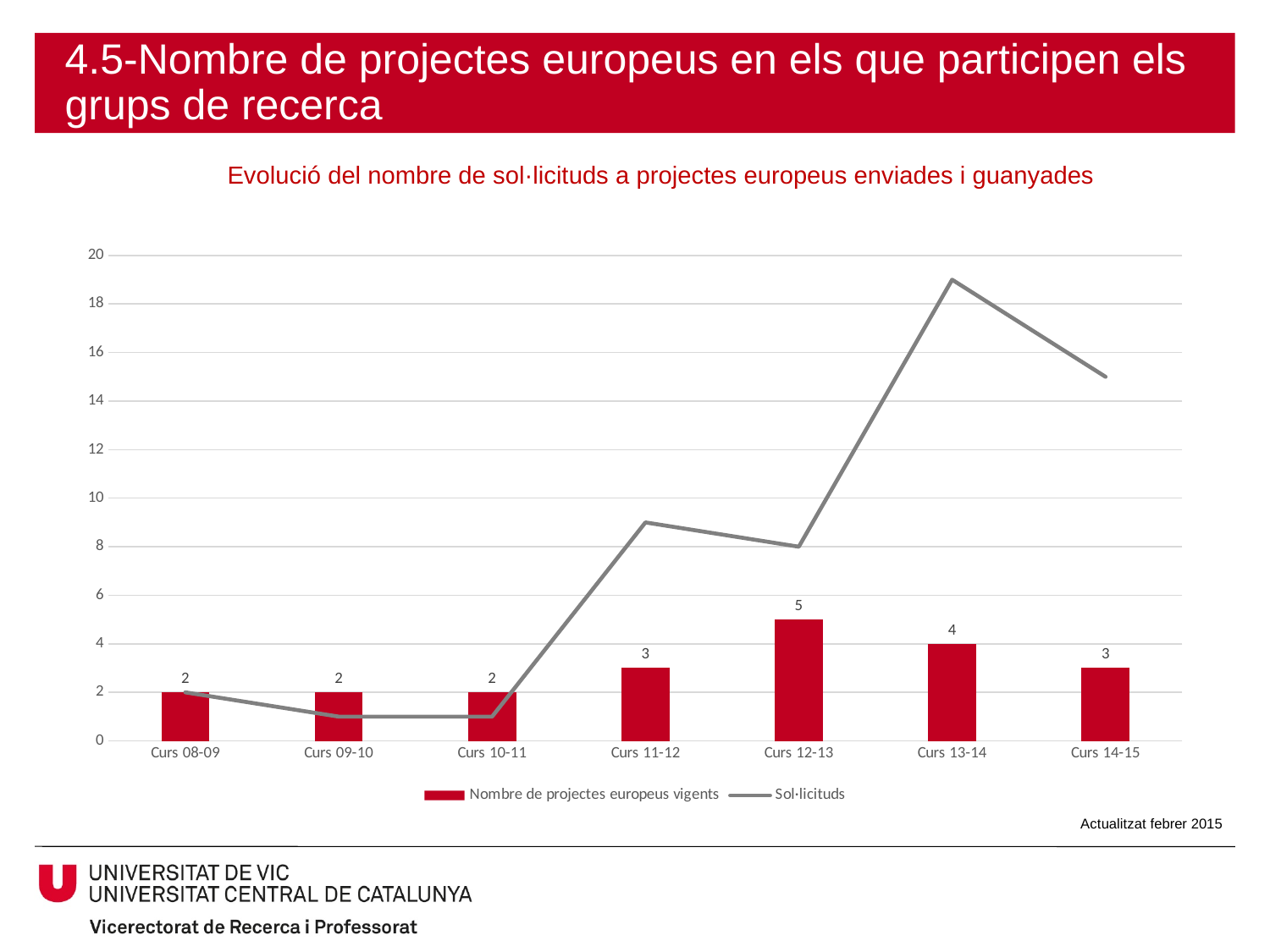
Does the Sol·licituds line rise or fall between Curs 13-14 and Curs 14-15? fall Which Curs has the highest value for Nombre de projectes europeus vigents? Curs 12-13 Is the Sol·licituds value for Curs 09-10 greater or less than 4? less Is the Sol·licituds value for Curs 11-12 greater or less than 6? greater What is the value of Nombre de projectes europeus vigents for Curs 12-13? 5 How many series does the legend list? 2 What is the title of the chart? Evolució del nombre de sol·licituds a projectes europeus enviades i guanyades What is the difference between the Nombre de projectes europeus vigents values for Curs 12-13 and Curs 13-14? 1 Which is larger, the Nombre de projectes europeus vigents value for Curs 11-12 or for Curs 13-14? Curs 13-14 Is the Sol·licituds value for Curs 13-14 greater or less than 16? greater How many Curs categories are shown on the x axis? 7 What is the value of Nombre de projectes europeus vigents for Curs 14-15? 3